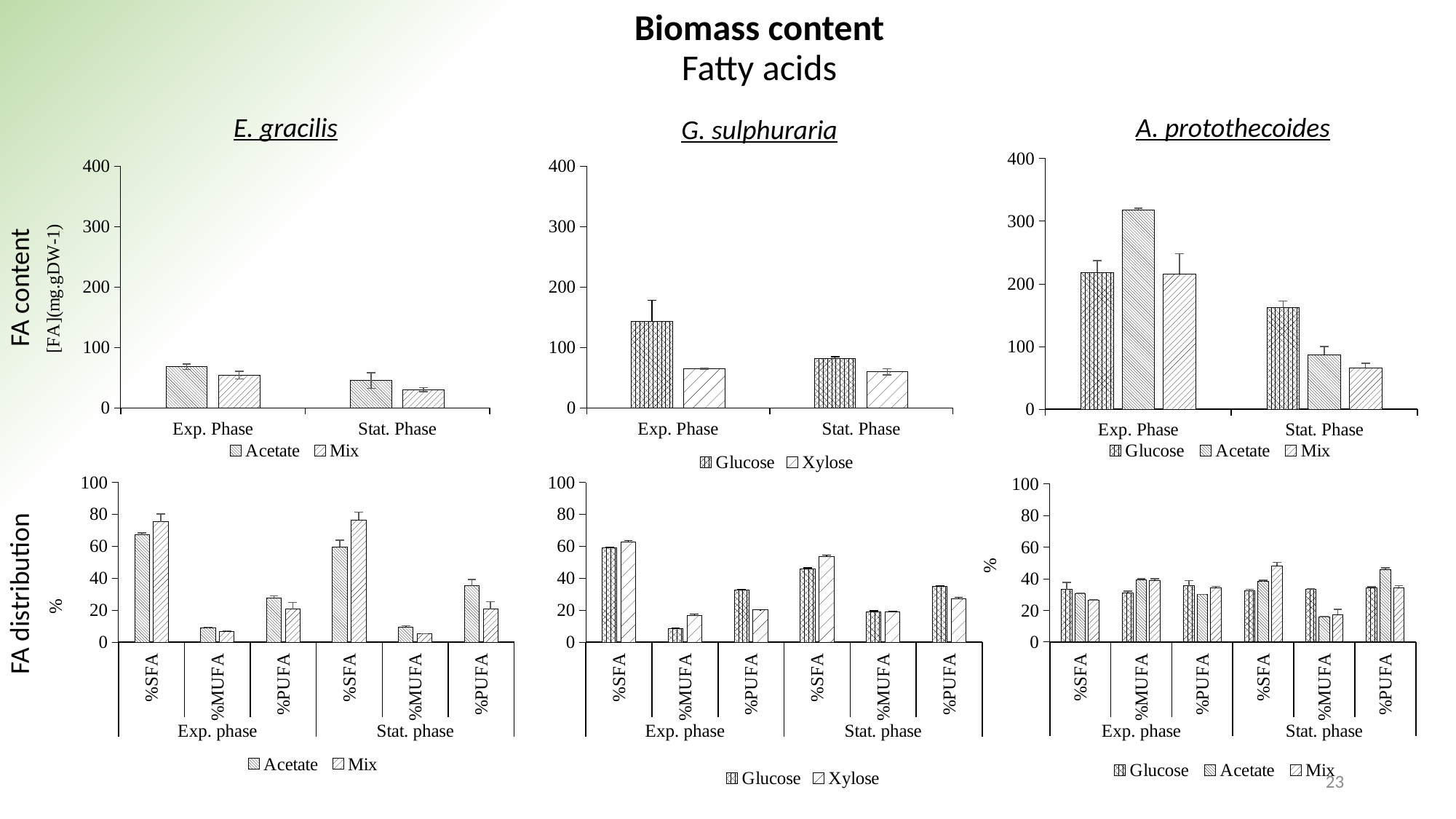
In the E. gracilis FA content chart, is the Mix value in the Stat. Phase greater or less than 50? less In the G. sulphuraria FA content chart, which is larger in the Exp. Phase, Glucose or Xylose? Glucose In the A. protothecoides FA content chart, which series has the highest value in the Exp. Phase? Acetate In the G. sulphuraria FA content chart, is the Glucose value in the Exp. Phase greater or less than 100? greater In the A. protothecoides FA content chart, how many series does the legend list? 3 In the E. gracilis FA distribution chart, which is larger for %SFA in the Exp. phase, Acetate or Mix? Mix In the G. sulphuraria FA content chart, how many series does the legend list? 2 What kind of chart is the E. gracilis FA content chart? Bar chart In the E. gracilis FA content chart, does the Acetate value rise or fall from the Exp. Phase to the Stat. Phase? fall In the A. protothecoides FA content chart, is the Acetate value in the Exp. Phase greater or less than 300? greater What is the y-axis label of the E. gracilis FA content chart? [FA](mg.gDW-1) In the A. protothecoides FA content chart, which series has the lowest value in the Stat. Phase? Mix